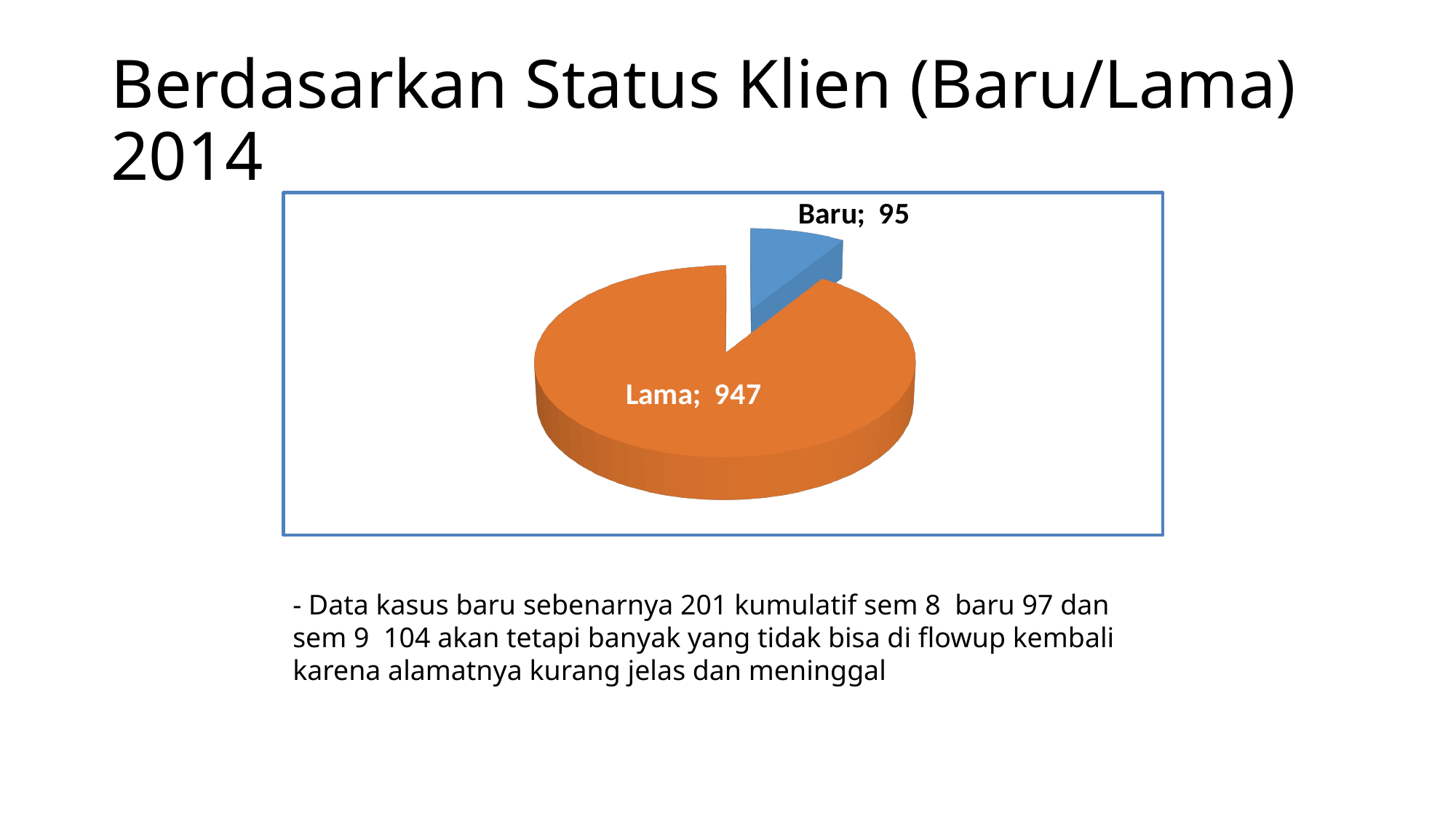
What is the value for Baru in the pie chart? 95 How many slices does the pie chart have? 2 What colour is the Baru slice in the pie chart? Blue Which is larger, the value for Baru or the value for Lama? Lama What share of the pie does the Baru slice represent, to the nearest whole percent? 9% Which category has the largest slice in the pie chart? Lama What is the difference between the values for Lama and Baru? 852 What kind of chart is shown on the slide? Pie chart What share of the pie does the Lama slice represent, to the nearest whole percent? 91% Which category has the smallest slice in the pie chart? Baru What is the value for Lama in the pie chart? 947 What is the total of all slices in the pie chart? 1042